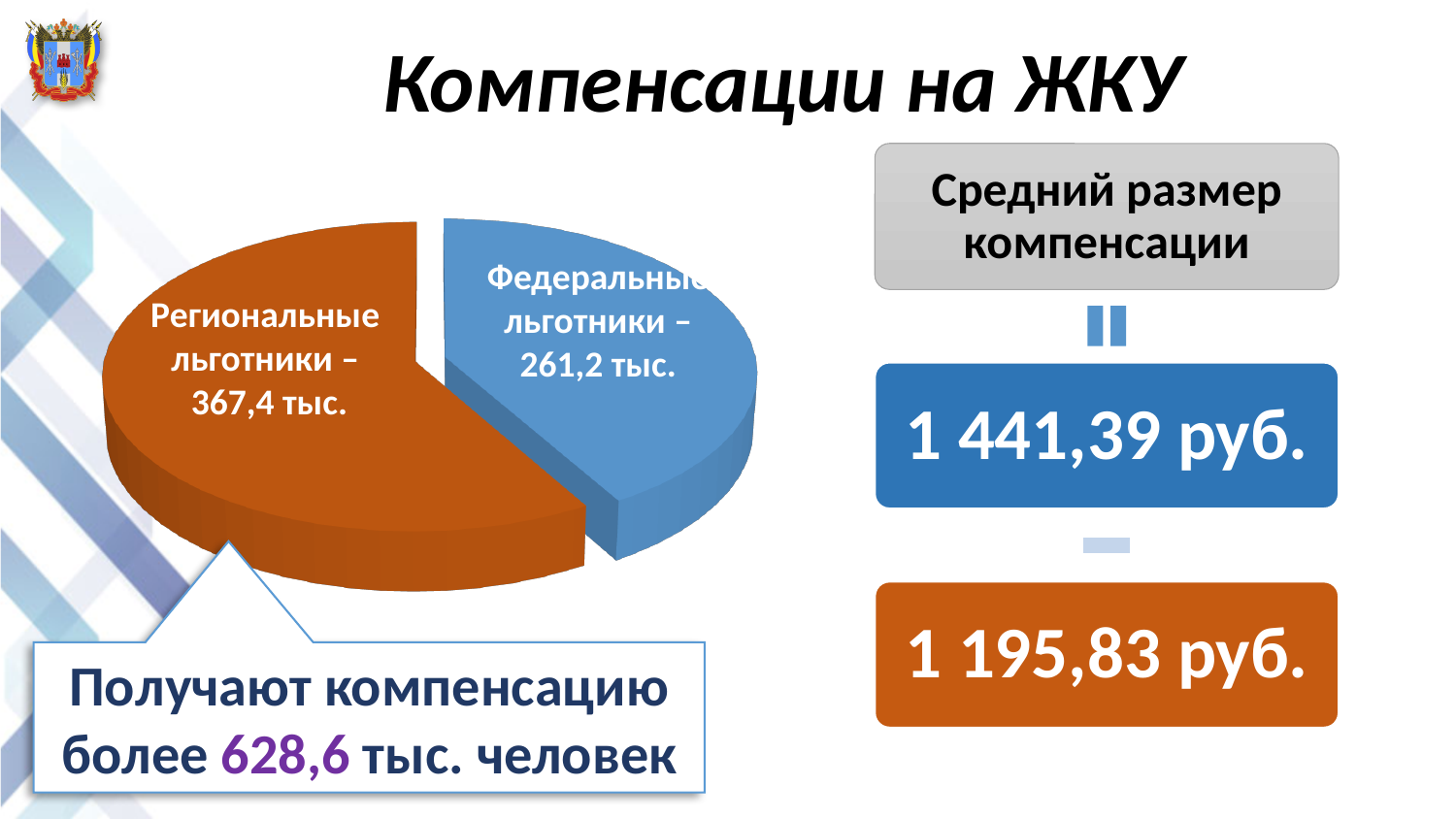
Is the value for Федеральные льготники larger or smaller than the value for Региональные льготники? Smaller What is the value shown for Региональные льготники in the pie chart? 367,4 тыс. What is the value shown for Федеральные льготники in the pie chart? 261,2 тыс. What type of chart is shown on the slide? Pie chart What colour is the slice for Федеральные льготники? Blue What is the difference between the values for Региональные льготники and Федеральные льготники? 106,2 тыс. How many slices does the pie chart have? 2 Which category has the smaller slice in the pie chart? Федеральные льготники Which category has the larger slice in the pie chart? Региональные льготники What colour is the slice for Региональные льготники? Orange What is the combined total of the two slices in the pie chart? 628,6 тыс.